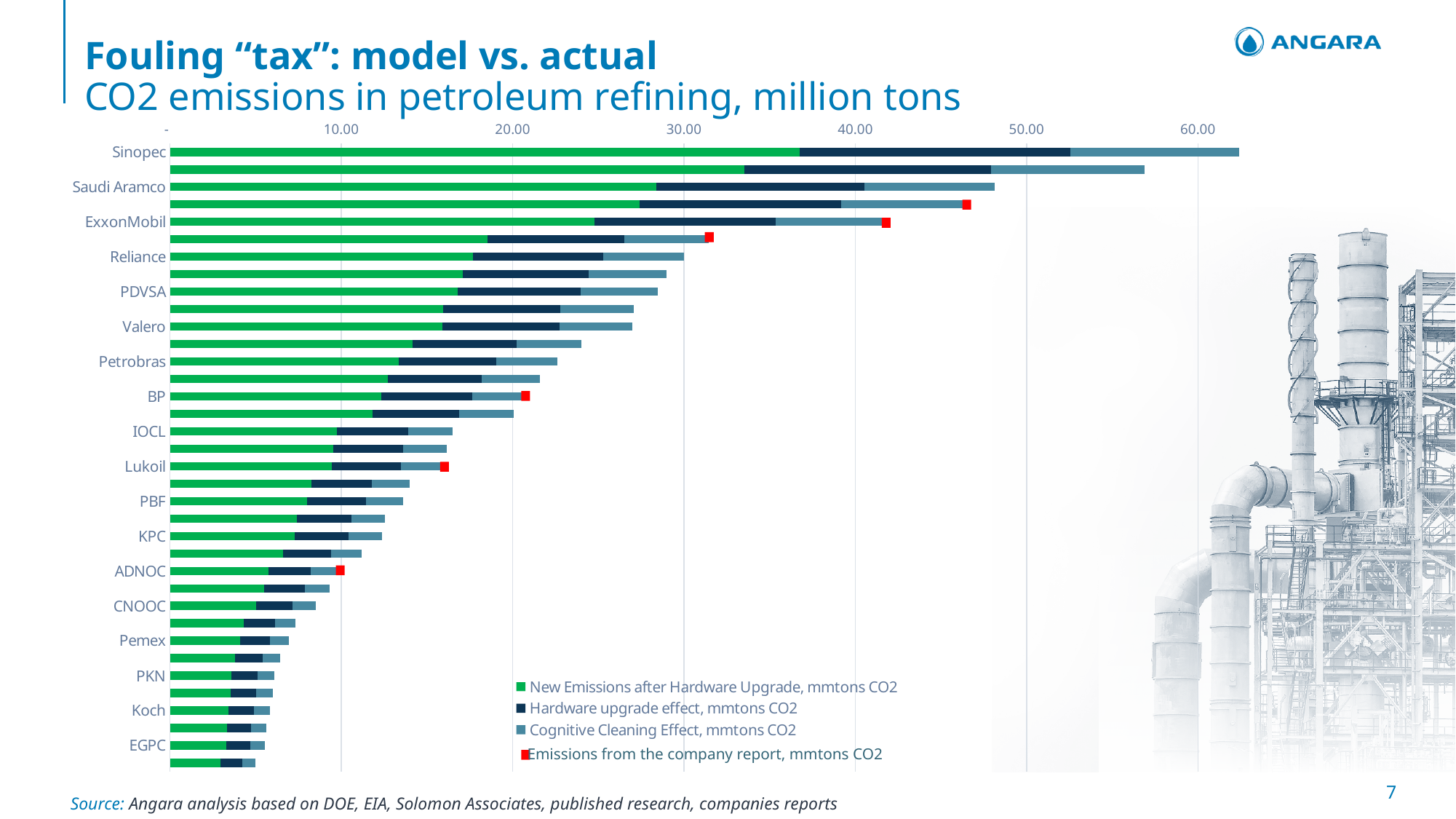
Which company has the highest total CO2 emissions bar? Sinopec Is the total bar for PDVSA greater or less than 30.00? less Is the total bar for IOCL greater or less than 20.00? less Is the total bar for Sinopec greater or less than 60.00? greater Which has the larger total bar, Sinopec or Saudi Aramco? Sinopec What kind of chart is shown on the slide? Stacked bar chart How many series does the legend list? 4 What do the red markers on the chart represent, according to the legend? Emissions from the company report, mmtons CO2 Do the total bars rise or fall going from the top of the chart (Sinopec) to the bottom (EGPC)? fall